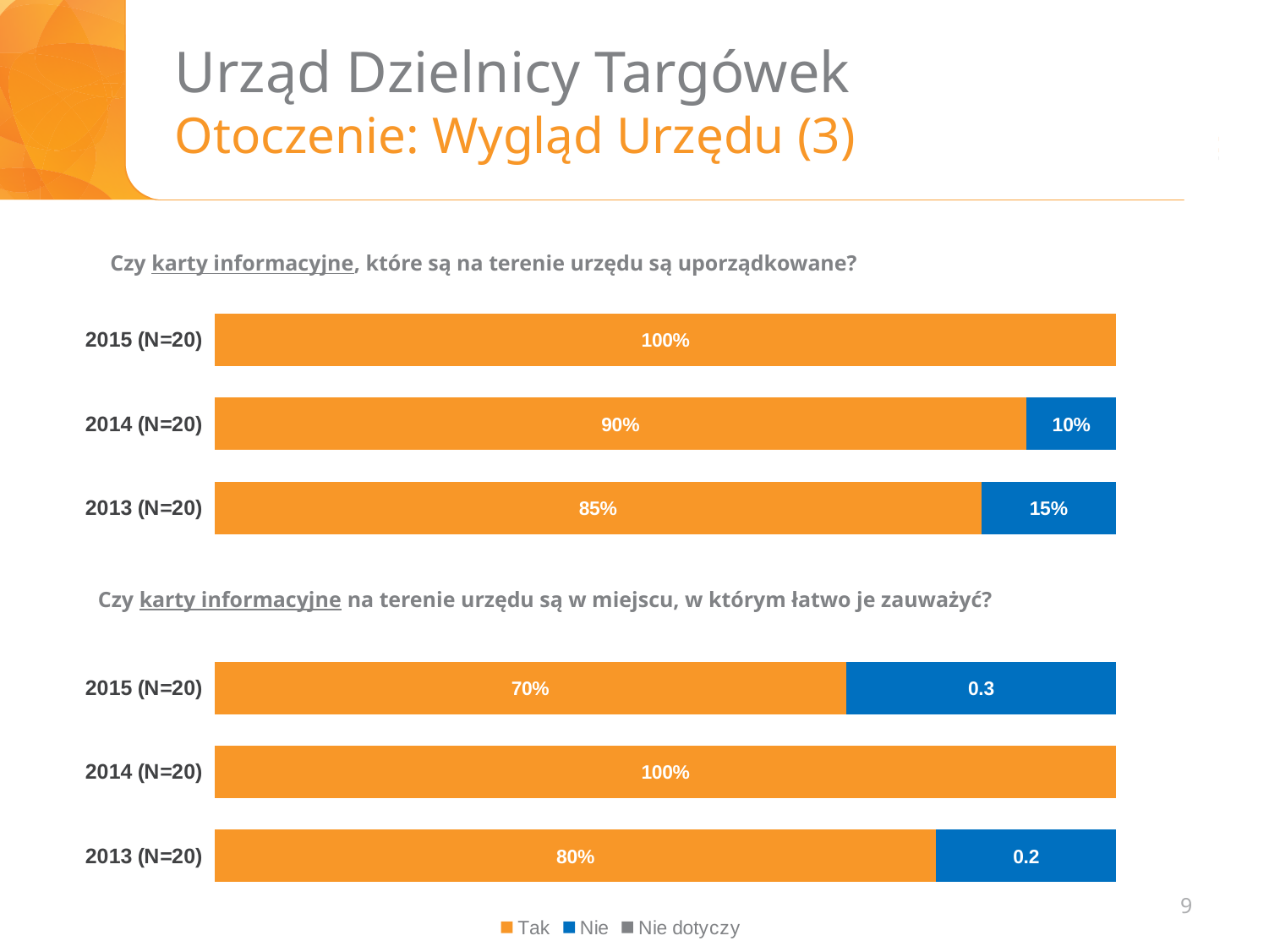
In the bottom chart (Czy karty informacyjne na terenie urzędu są w miejscu, w którym łatwo je zauważyć?), is the Tak value larger in 2013 (N=20) or 2015 (N=20)? 2013 (N=20) In the top chart (Czy karty informacyjne, które są na terenie urzędu są uporządkowane?), what is the difference between the Tak values for 2014 (N=20) and 2013 (N=20)? 5% In the bottom chart (Czy karty informacyjne na terenie urzędu są w miejscu, w którym łatwo je zauważyć?), what is the label shown on the Nie segment for 2013 (N=20)? 0.2 How many year categories does the top chart (Czy karty informacyjne, które są na terenie urzędu są uporządkowane?) show? 3 In the top chart (Czy karty informacyjne, które są na terenie urzędu są uporządkowane?), does the Tak value rise or fall from 2013 to 2015? rise In the top chart (Czy karty informacyjne, które są na terenie urzędu są uporządkowane?), which year has the highest Tak value? 2015 (N=20) In the bottom chart (Czy karty informacyjne na terenie urzędu są w miejscu, w którym łatwo je zauważyć?), which year has the lowest Tak value? 2015 (N=20) How many series does the legend at the bottom of the slide list? 3 What type of chart is the bottom chart (Czy karty informacyjne na terenie urzędu są w miejscu, w którym łatwo je zauważyć?)? stacked bar chart In the bottom chart (Czy karty informacyjne na terenie urzędu są w miejscu, w którym łatwo je zauważyć?), what is the value for Tak in 2015 (N=20)? 70% In the top chart (Czy karty informacyjne, które są na terenie urzędu są uporządkowane?), what is the value for Tak in 2014 (N=20)? 90% In the top chart (Czy karty informacyjne, które są na terenie urzędu są uporządkowane?), what is the value for Nie in 2013 (N=20)? 15%